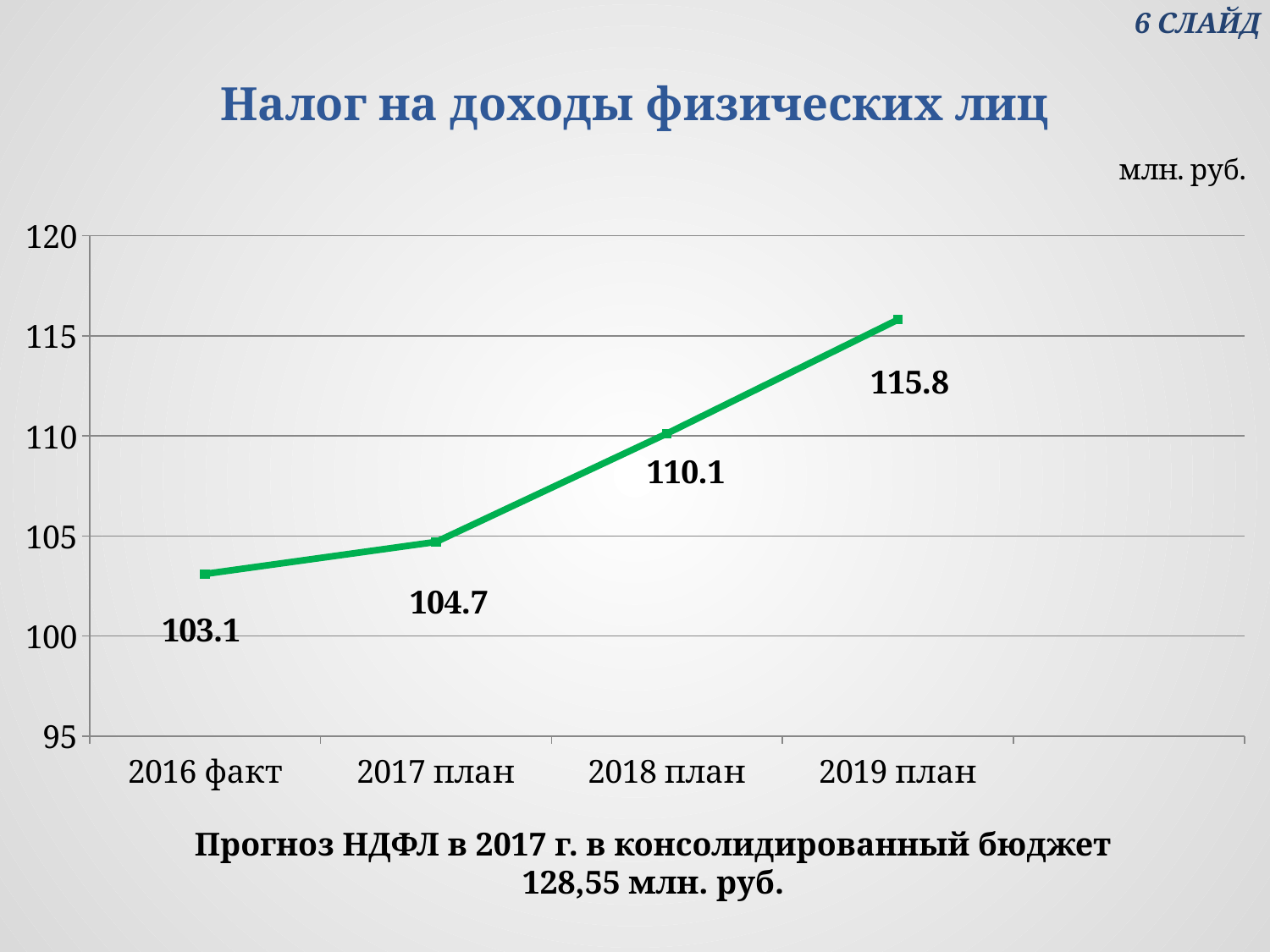
What is the value for 2016 факт? 103.1 What is the value for 2019 план? 115.8 What is the difference between the values for 2019 план and 2016 факт? 12.7 Which category has the lowest value? 2016 факт What is the value for 2018 план? 110.1 Do the values rise or fall from 2016 факт to 2019 план? rise How many data points are plotted on the chart? 4 What kind of chart is shown on the slide? line chart Which is larger, the value for 2018 план or the value for 2017 план? 2018 план What is the difference between the values for 2018 план and 2017 план? 5.4 Which category has the highest value? 2019 план What is the value for 2017 план? 104.7